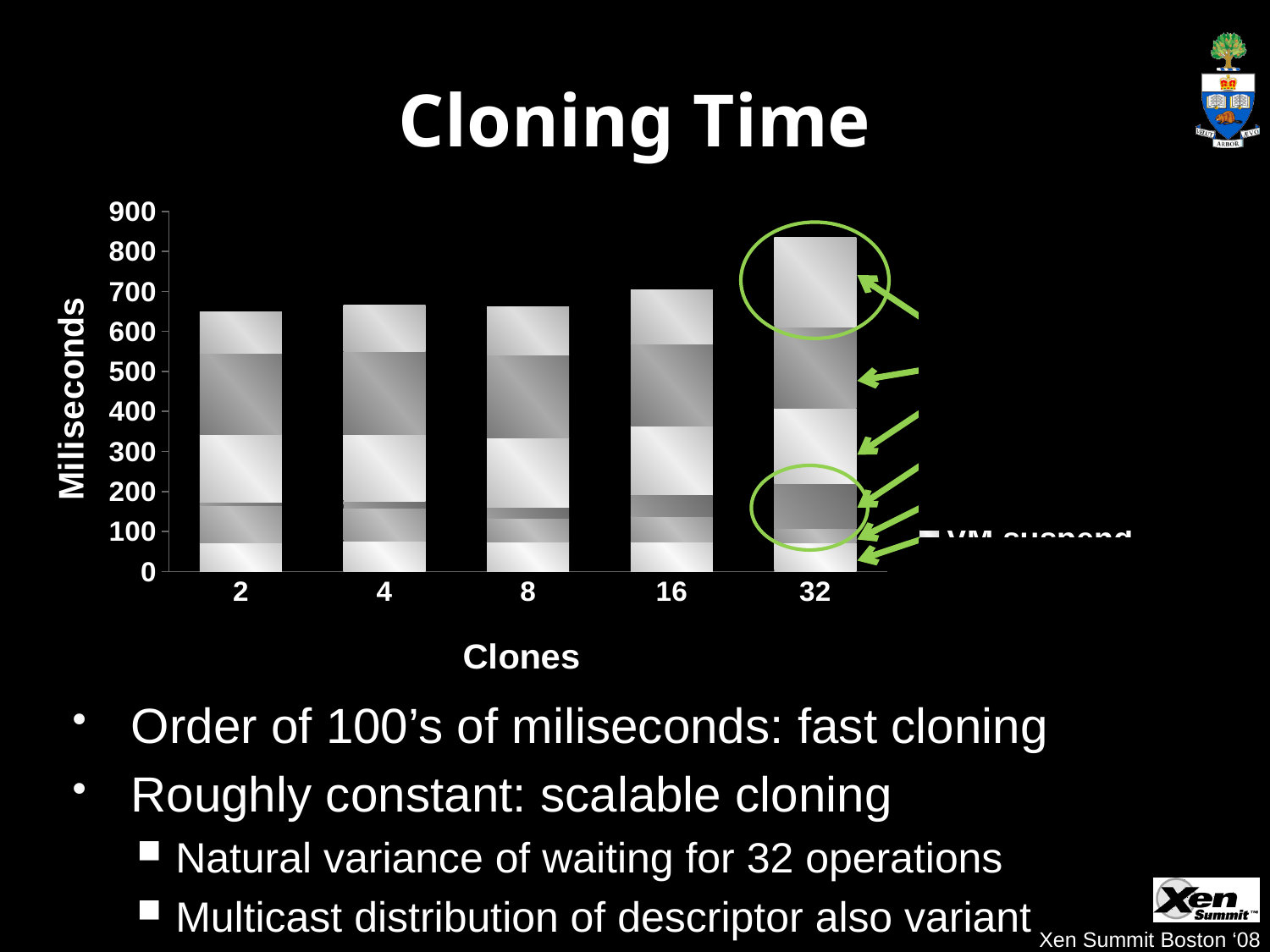
Which number of clones has the tallest bar? 32 Which bar is taller, the one for 16 clones or the one for 32 clones? 32 clones What kind of chart is shown on the slide? stacked bar chart What is the highest value shown on the y axis? 900 What is the title of the chart? Cloning Time Is the total cloning time for 2 clones greater or less than 700 milliseconds? less Which bar is taller, the one for 32 clones or the one for 2 clones? 32 clones Is the total cloning time for 32 clones greater or less than 800 milliseconds? greater Is the total cloning time for 16 clones greater or less than 600 milliseconds? greater What is the label on the y axis of the chart? Miliseconds How many clone counts (categories) are plotted along the x axis? 5